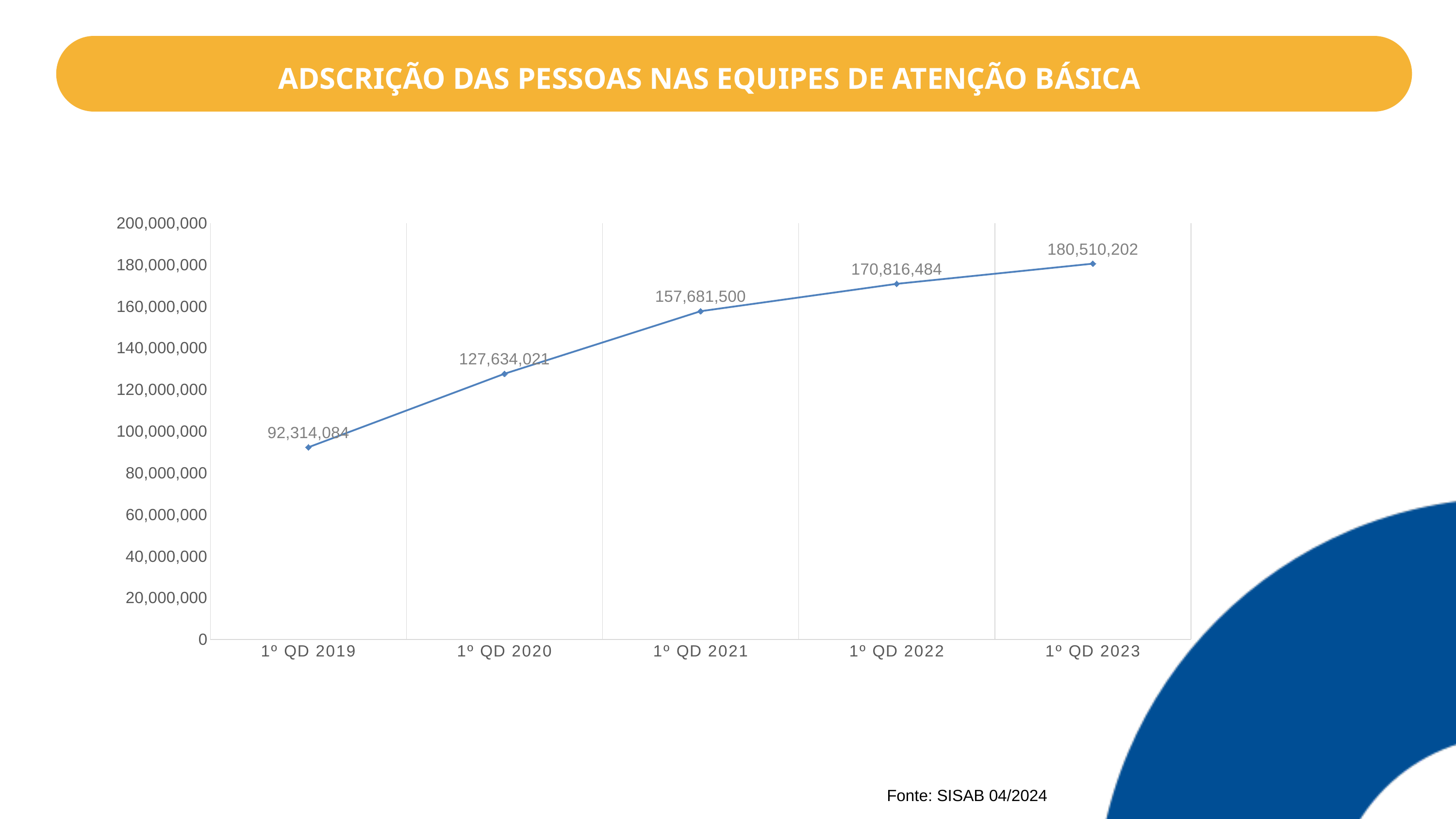
Do the values rise or fall from 1º QD 2019 to 1º QD 2023? rise Which is larger, the value for 1º QD 2020 or the value for 1º QD 2021? 1º QD 2021 What is the difference between the values for 1º QD 2023 and 1º QD 2022? 9,693,718 Which period has the lowest value? 1º QD 2019 What is the value for 1º QD 2019? 92,314,084 Which period has the highest value? 1º QD 2023 Is the value for 1º QD 2022 greater or less than 160,000,000? greater What kind of chart is shown on the slide? line chart What is the difference between the values for 1º QD 2020 and 1º QD 2019? 35,319,937 What is the value for 1º QD 2023? 180,510,202 What is the value for 1º QD 2021? 157,681,500 How many data points are plotted on the chart? 5